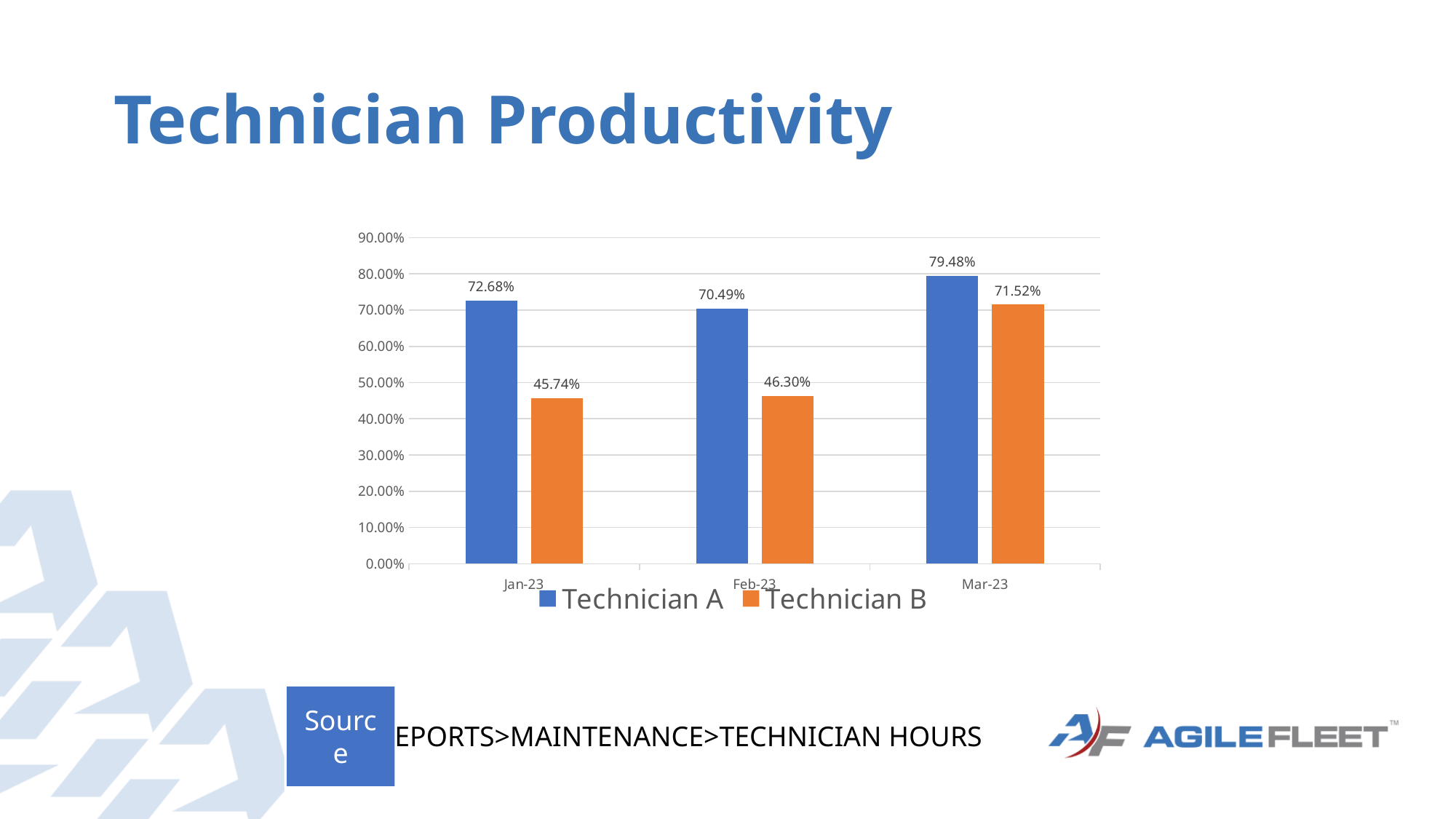
Which is larger in Feb-23, Technician A or Technician B? Technician A What is the difference between Technician A and Technician B in Jan-23? 26.94% What is the value for Technician B in Feb-23? 46.30% In which month is Technician B's value lowest? Jan-23 In which month is Technician A's value highest? Mar-23 How many months are shown on the x axis? 3 What is the value for Technician A in Jan-23? 72.68% Is the value for Technician B in Mar-23 greater or less than 60.00%? greater What is the difference between Technician A and Technician B in Mar-23? 7.96% How many series does the legend list? 2 What is the value for Technician B in Mar-23? 71.52% What kind of chart is shown on the slide? Bar chart